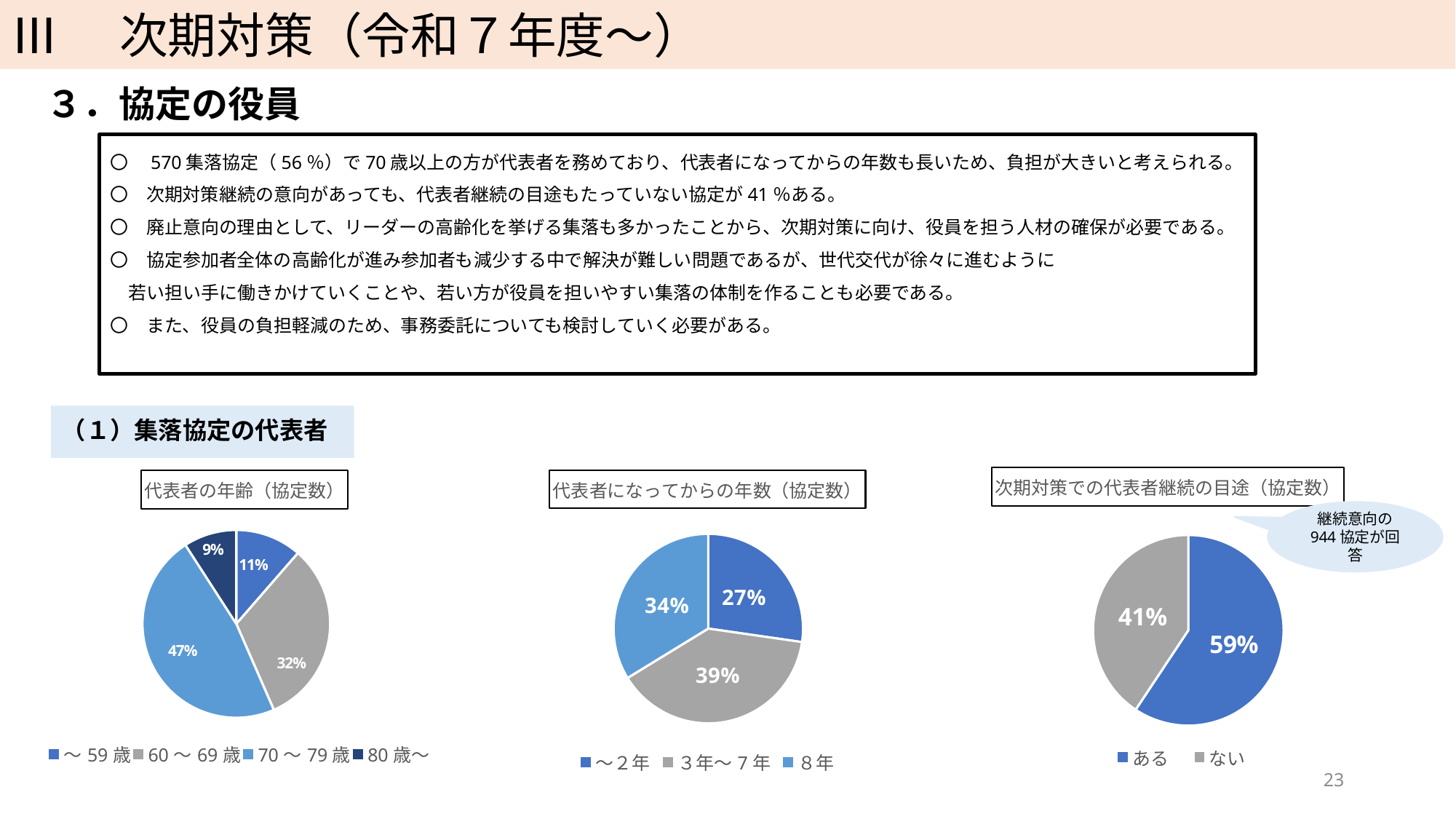
In the chart titled 代表者の年齢（協定数）, which age category has the largest share? 70～79歳 In the chart titled 代表者の年齢（協定数）, how many categories does the legend list? 4 In the chart titled 代表者になってからの年数（協定数）, what share is shown for 3年～7年? 39% In the chart titled 次期対策での代表者継続の目途（協定数）, what share is shown for ある? 59% In the chart titled 代表者になってからの年数（協定数）, which category has the smallest share? ～2年 In the chart titled 代表者の年齢（協定数）, what share is shown for 70～79歳? 47% In the chart titled 代表者になってからの年数（協定数）, which is larger, the share for 8年 or the share for ～2年? 8年 What kind of chart is the chart titled 次期対策での代表者継続の目途（協定数）? Pie chart In the chart titled 次期対策での代表者継続の目途（協定数）, what is the difference between the shares for ある and ない? 18% In the chart titled 代表者の年齢（協定数）, which age category has the smallest share? 80歳～ How many pie charts are shown on the slide? 3 In the chart titled 代表者の年齢（協定数）, what is the difference between the shares for 60～69歳 and ～59歳? 21%